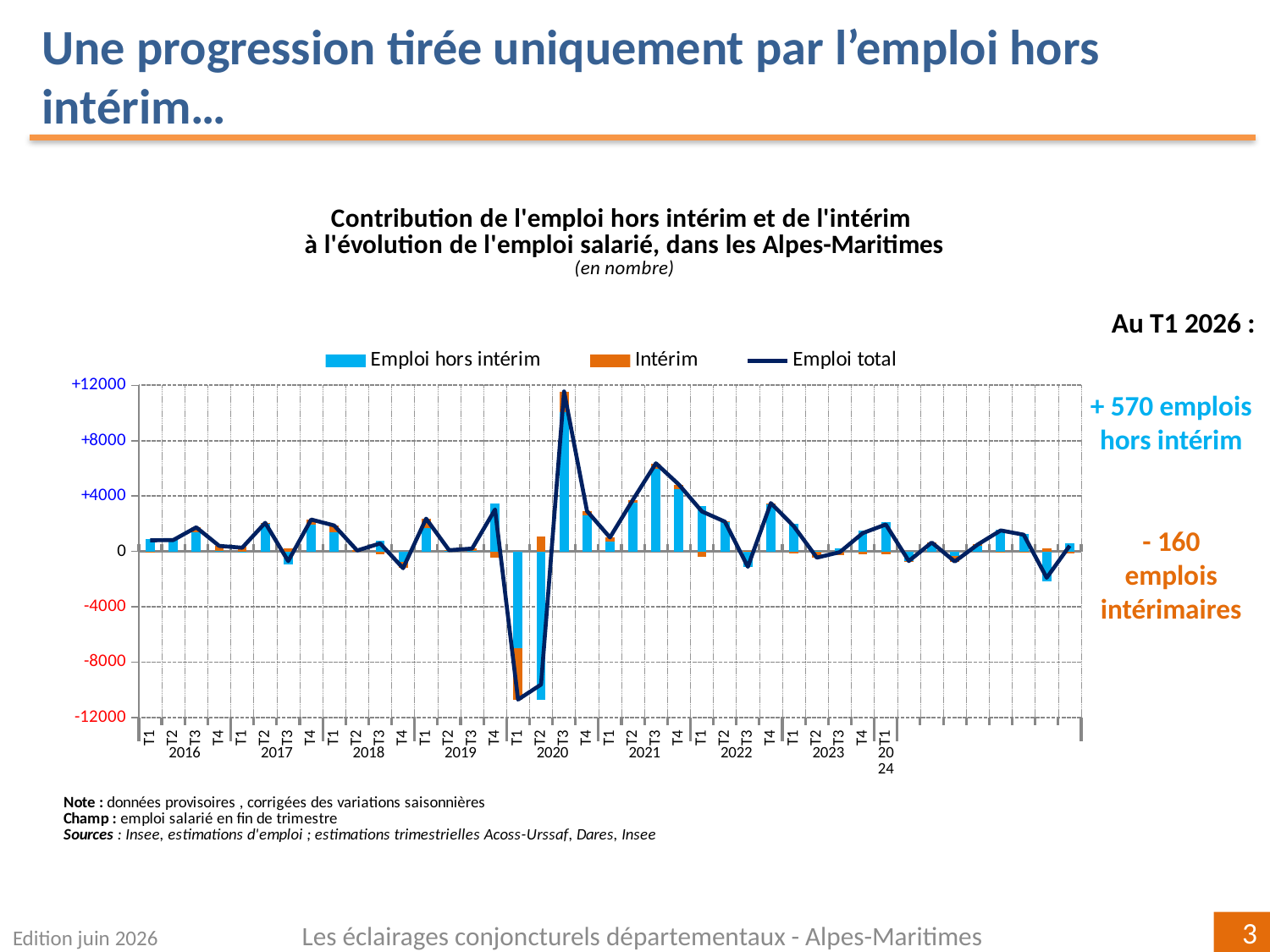
According to the annotation on the right, what is the change in emplois intérimaires at T1 2026? - 160 Is the Emploi total value for T3 2020 greater or less than +8000? greater According to the annotation on the right, what is the change in emploi hors intérim at T1 2026? + 570 What colour are the bars for the Intérim series? Orange Does the Emploi total line rise or fall between T3 2020 and T1 2021? Fall How many series does the chart legend list? 3 What kind of chart is shown on the slide? A combined bar and line chart What are the three series listed in the chart legend? Emploi hors intérim, Intérim, Emploi total Is the Emploi hors intérim value for T1 2020 greater or less than -4000? less In which quarter does the Emploi total line reach its highest value? T3 2020 In which quarter is the Emploi hors intérim bar the highest? T3 2020 Which is larger, the Emploi total value for T3 2020 or for T3 2021? T3 2020